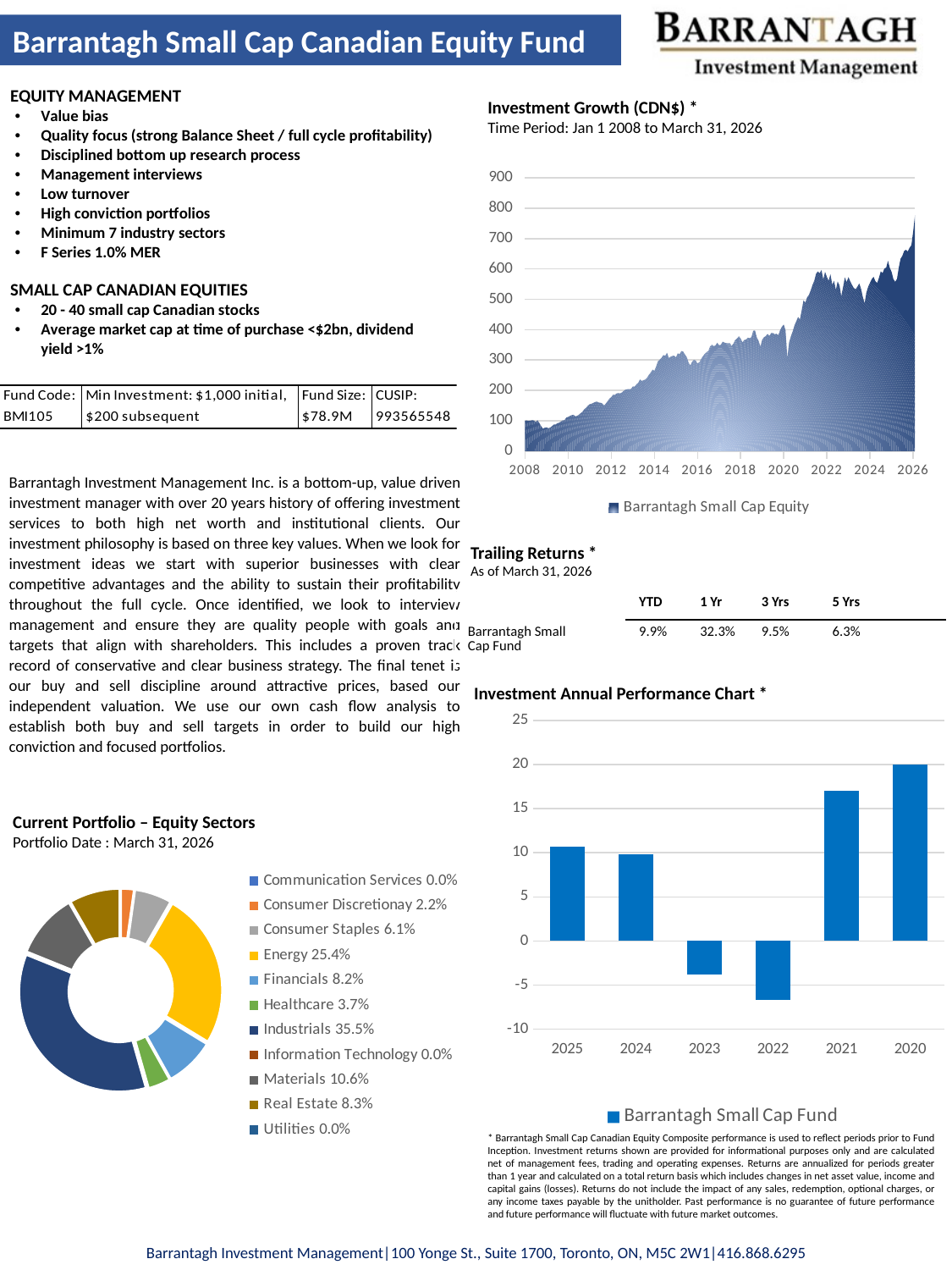
In the Investment Annual Performance Chart, is the value for 2022 greater or less than -5? less What kind of chart is the Investment Annual Performance Chart? Bar chart In the Current Portfolio – Equity Sectors chart, what is the difference between the Industrials share and the Energy share? 10.1 percentage points In the Investment Growth (CDN$) chart, do the values generally rise or fall from 2008 to 2026? Rise In the Current Portfolio – Equity Sectors chart, how many sectors are listed in the legend? 11 In the Current Portfolio – Equity Sectors chart, which sector has the largest share? Industrials In the Current Portfolio – Equity Sectors chart, which is larger, Materials or Financials? Materials In the Investment Annual Performance Chart, which year has the lowest bar? 2022 In the Investment Annual Performance Chart, which year has the highest bar? 2020 In the Current Portfolio – Equity Sectors chart, what share of the portfolio is Energy? 25.4% In the Investment Annual Performance Chart, is the value for 2021 greater or less than 15? greater In the Investment Annual Performance Chart, how many years are shown on the x axis? 6